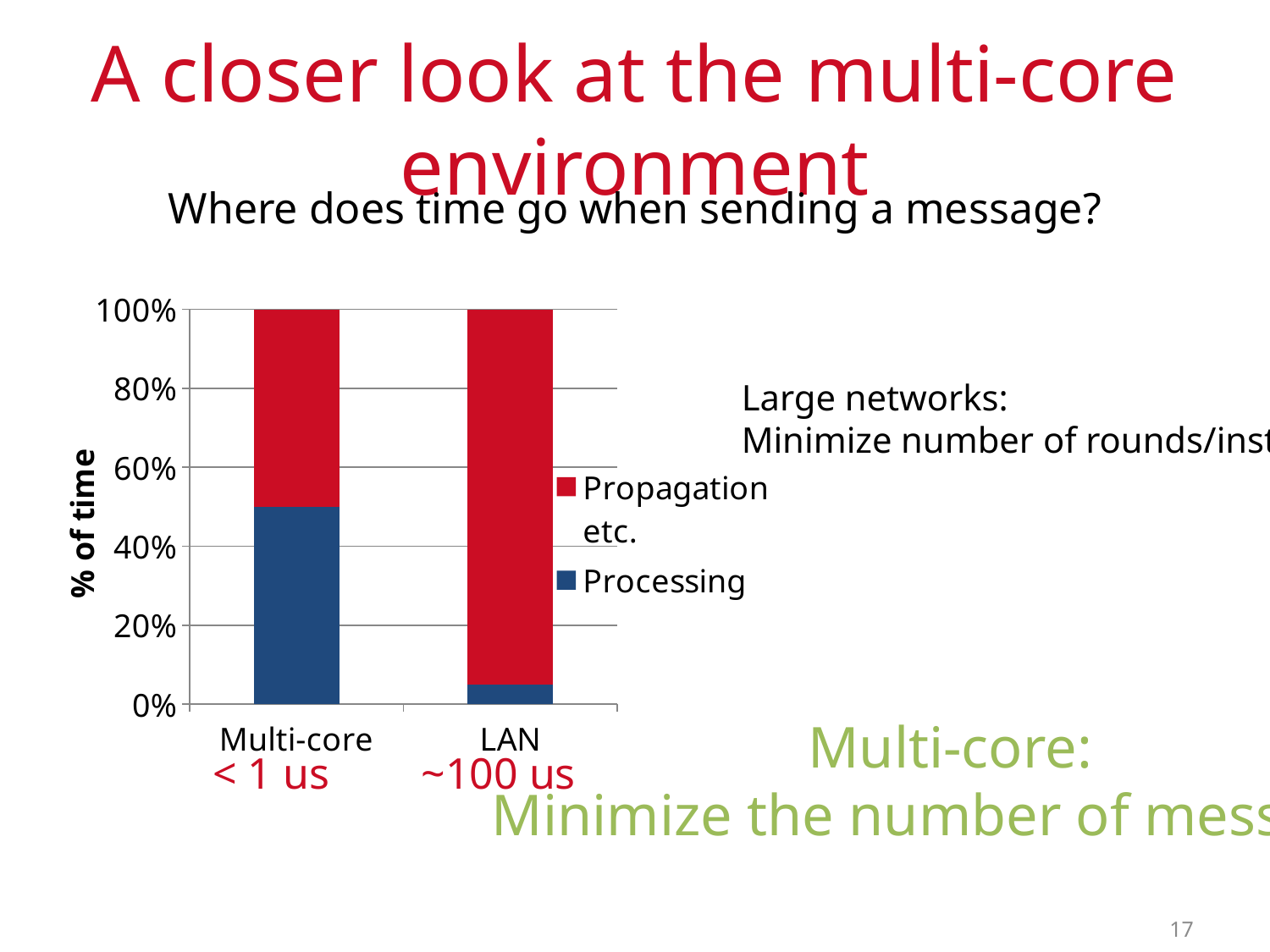
Which category has the larger Processing share of time, Multi-core or LAN? Multi-core What kind of chart is shown on the slide? stacked bar chart What is the total height of the stacked bar for LAN? 100% What is the label of the chart's y axis? % of time Is the Processing value for Multi-core greater or less than 60%? less How many categories are shown on the x axis of the chart? 2 Is the Processing value for Multi-core greater or less than 40%? greater Which series is shown in red in the chart? Propagation etc. Is the Processing value for LAN greater or less than 20%? less Which category has the larger Propagation etc. share of time, Multi-core or LAN? LAN Which category has the lowest Processing share of time? LAN How many series does the chart's legend list? 2